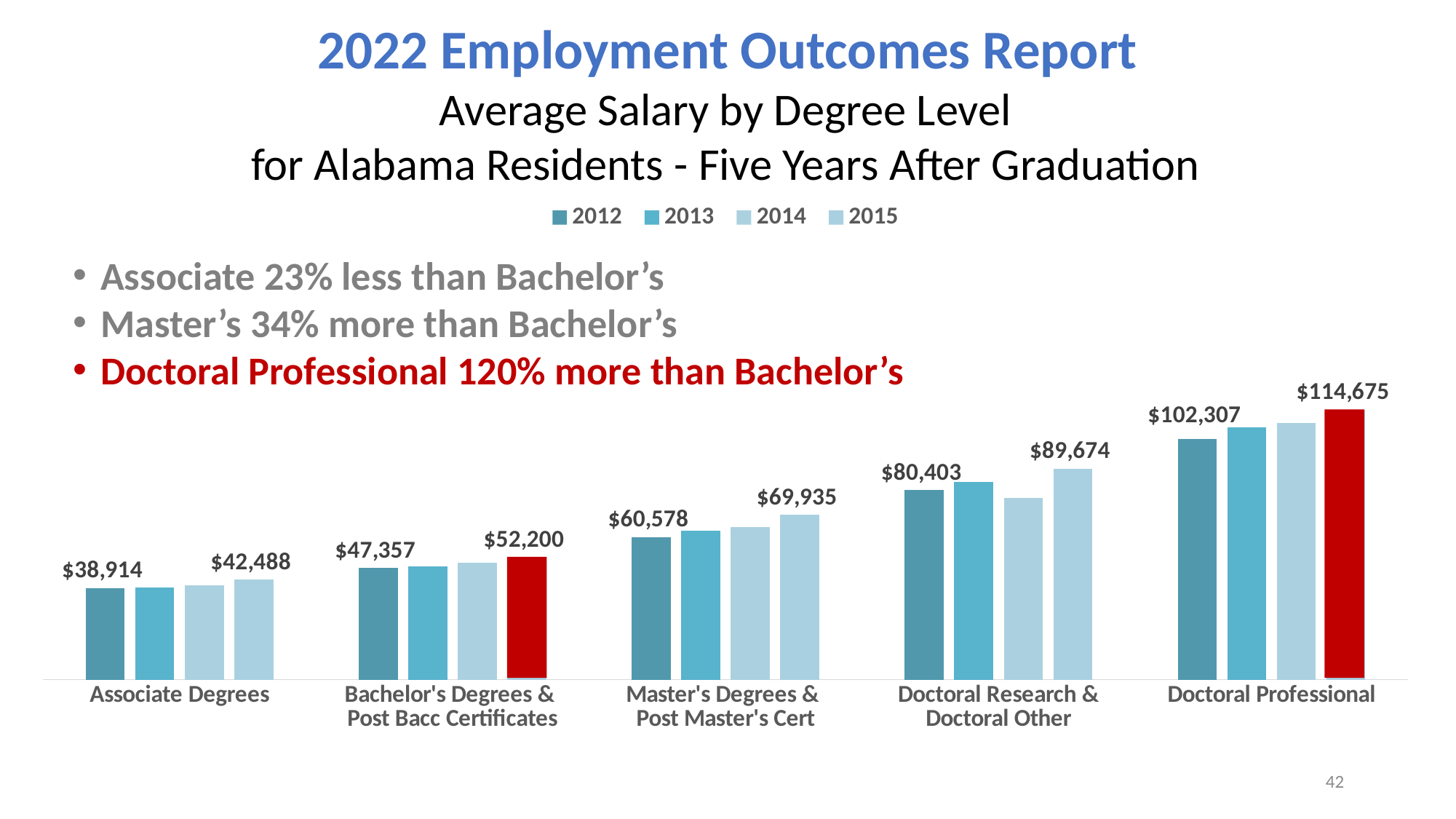
What is the 2015 average salary for Doctoral Professional degrees? $114,675 Which degree level has the lowest 2012 average salary? Associate Degrees What is the 2015 average salary for Master's Degrees & Post Master's Cert? $69,935 What is the difference between the 2015 and 2012 average salaries for Doctoral Professional degrees? $12,368 Which is larger: the 2015 salary for Bachelor's Degrees & Post Bacc Certificates or the 2012 salary for Master's Degrees & Post Master's Cert? 2012 salary for Master's Degrees & Post Master's Cert How many series does the legend list? 4 Which degree level has the highest 2015 average salary? Doctoral Professional What is the 2012 average salary for Associate Degrees? $38,914 What is the difference between the 2015 and 2012 average salaries for Associate Degrees? $3,574 What is the 2012 average salary for Doctoral Research & Doctoral Other? $80,403 How many degree-level categories are shown on the x axis? 5 What kind of chart is shown on the slide? Bar chart